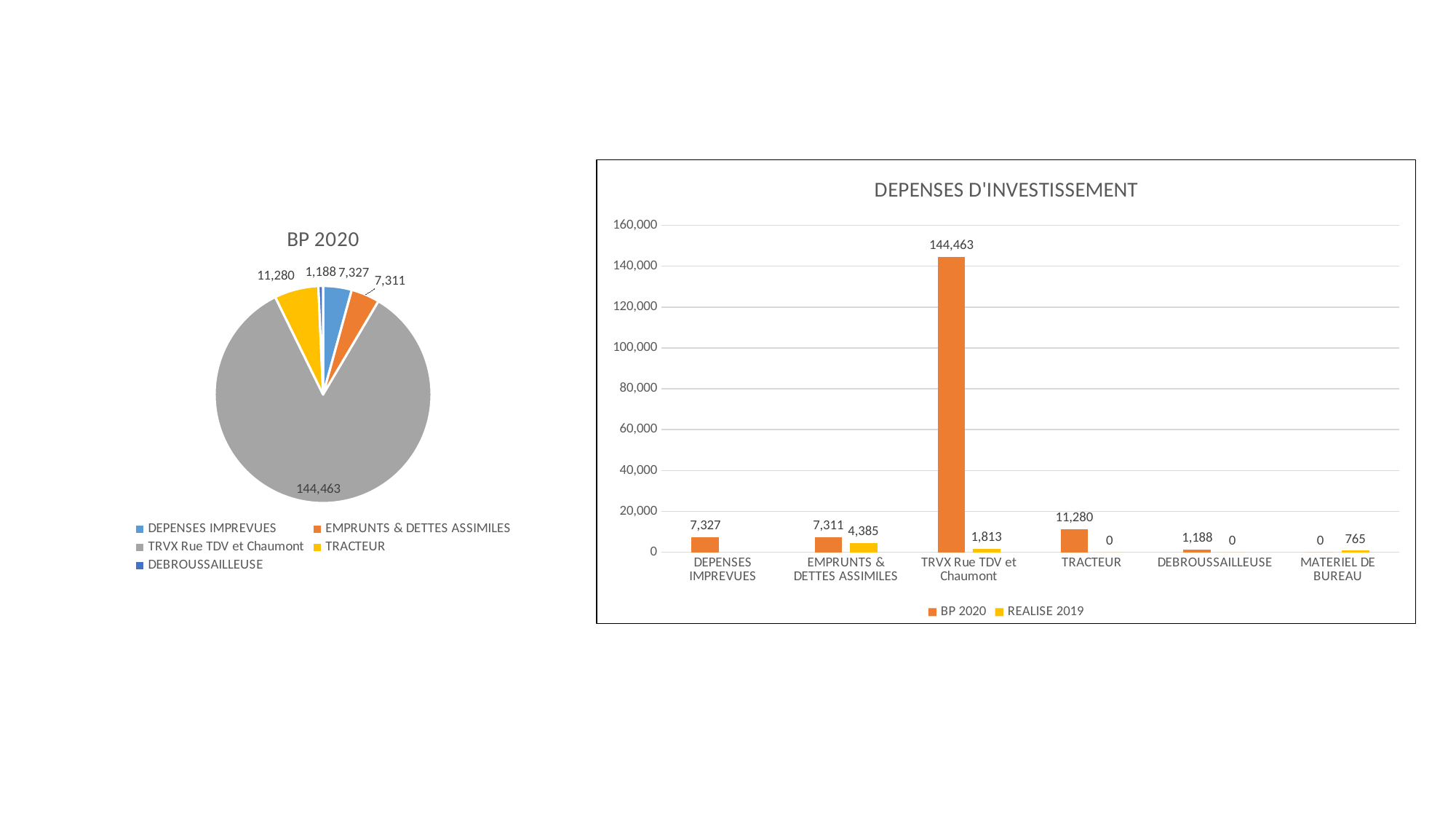
In the DEPENSES D'INVESTISSEMENT chart, what is the REALISE 2019 value for EMPRUNTS & DETTES ASSIMILES? 4,385 In the BP 2020 pie chart, what is the value for TRACTEUR? 11,280 In the DEPENSES D'INVESTISSEMENT chart, what is the BP 2020 value for TRVX Rue TDV et Chaumont? 144,463 In the BP 2020 pie chart, which category has the largest slice? TRVX Rue TDV et Chaumont How many categories does the legend of the BP 2020 pie chart list? 5 What type of chart is the chart titled BP 2020? pie chart In the BP 2020 pie chart, which category has the smallest slice? DEBROUSSAILLEUSE In the DEPENSES D'INVESTISSEMENT chart, what is the difference between the BP 2020 and REALISE 2019 values for TRVX Rue TDV et Chaumont? 142,650 In the DEPENSES D'INVESTISSEMENT chart, how many series does the legend list? 2 In the DEPENSES D'INVESTISSEMENT chart, which is larger for MATERIEL DE BUREAU: BP 2020 or REALISE 2019? REALISE 2019 What type of chart is the chart titled DEPENSES D'INVESTISSEMENT? bar chart In the DEPENSES D'INVESTISSEMENT chart, how many categories are shown on the x axis? 6